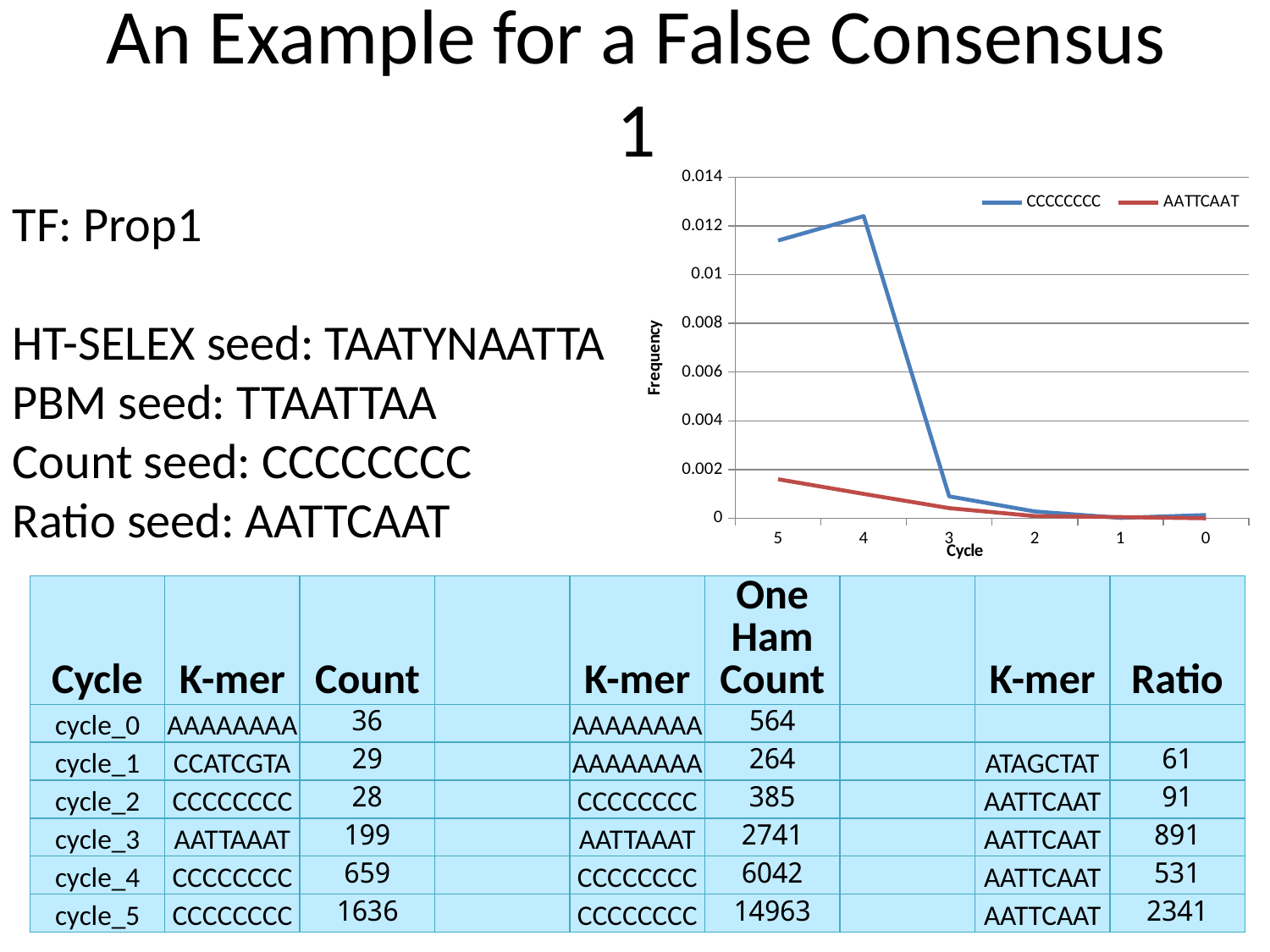
Is the frequency of AATTCAAT at cycle 5 greater or less than 0.002? less Is the frequency of CCCCCCCC at cycle 5 greater or less than 0.01? greater What are the two series named in the chart's legend? CCCCCCCC and AATTCAAT Is the frequency of CCCCCCCC at cycle 4 greater or less than 0.01? greater What is the label of the chart's vertical axis? Frequency How many cycle values are marked along the chart's x axis? 6 At cycle 5, which series has the higher frequency, CCCCCCCC or AATTCAAT? CCCCCCCC What kind of chart is shown on the slide? line chart Does the frequency of CCCCCCCC rise or fall between cycle 4 and cycle 3? fall How many series does the chart's legend list? 2 At which cycle does the CCCCCCCC series reach its highest frequency? 4